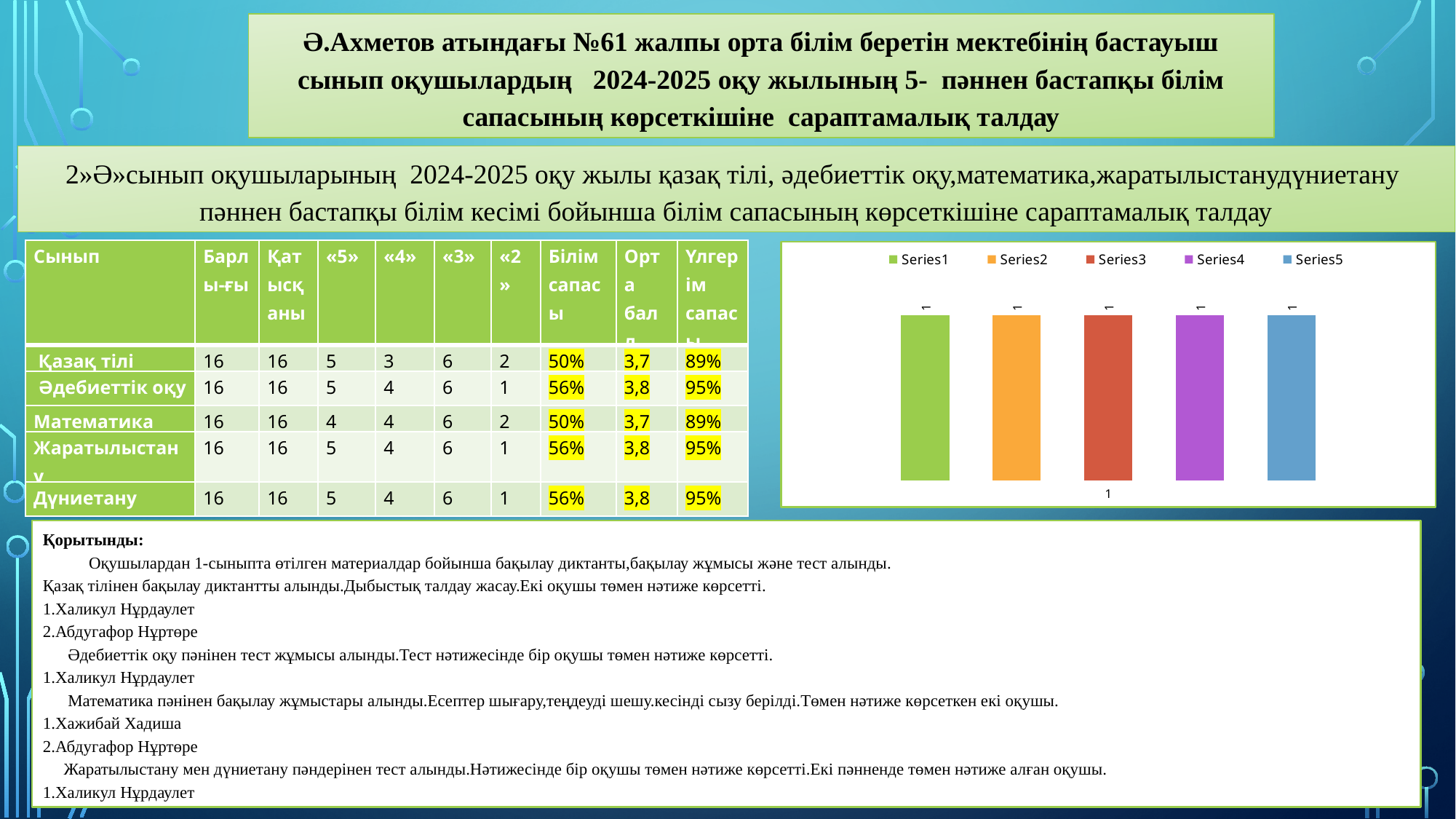
What is the data label value for Series1 in the chart? 1 What colour is the bar for Series1 in the chart? green What kind of chart is shown on the slide? bar chart What is the data label value for Series5 in the chart? 1 What is the difference between the values for Series2 and Series4 in the chart? 0 How many categories are shown on the x axis of the chart? 1 How many series does the chart legend list? 5 What is the category label shown on the x axis of the chart? 1 What is the data label value for Series3 in the chart? 1